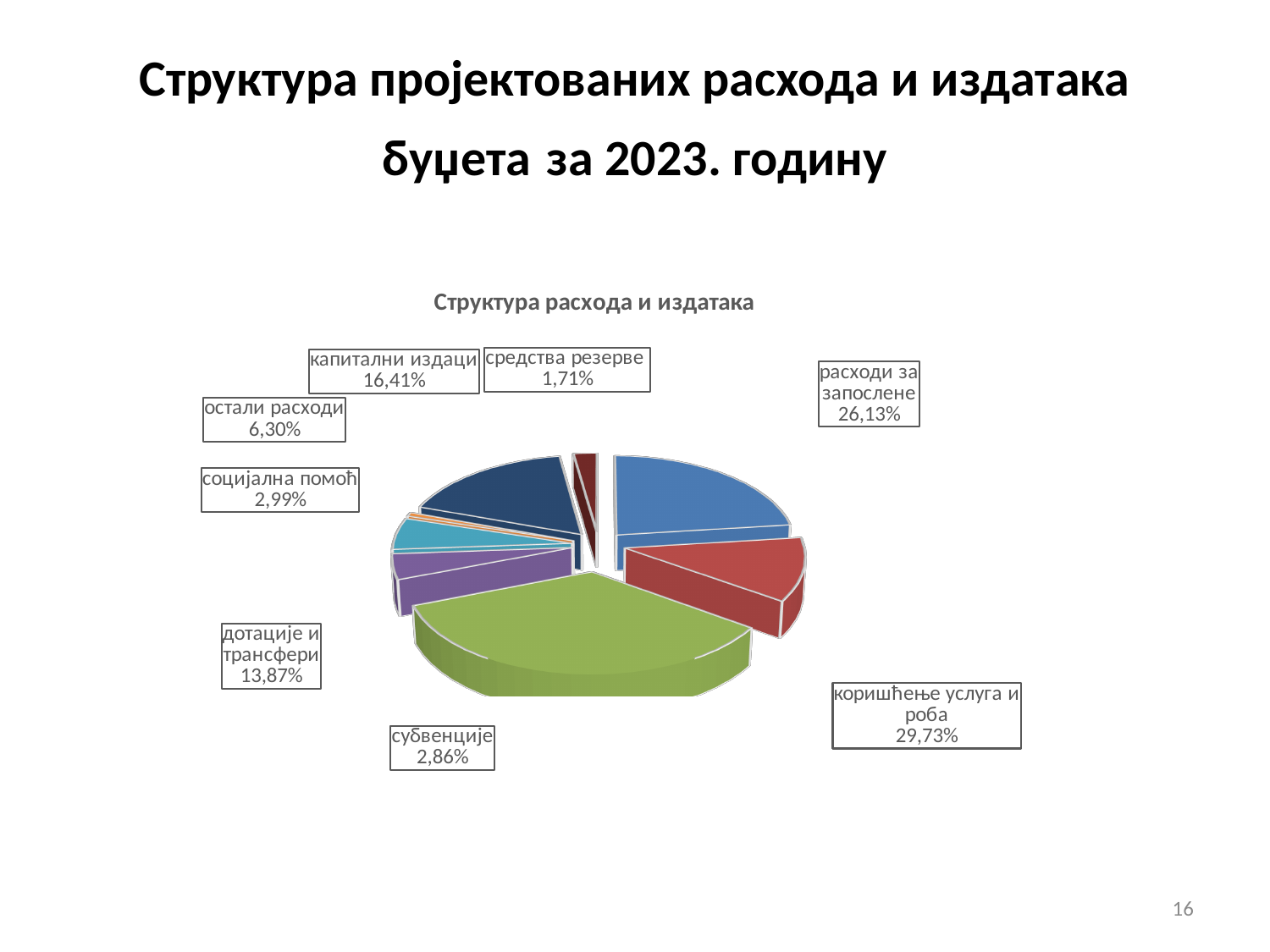
How many slices does the pie chart have? 8 Which category has the largest share of the pie? коришћење услуга и роба Which is larger, the share for остали расходи or the share for социјална помоћ? остали расходи What share of the pie is labelled for расходи за запослене? 26,13% What is the difference in percentage points between коришћење услуга и роба and расходи за запослене? 3,60 What kind of chart is shown on the slide? pie chart What share of the pie is labelled for коришћење услуга и роба? 29,73% Which category has the smallest share of the pie? средства резерве What share of the pie is labelled for средства резерве? 1,71% What is the chart's title? Структура расхода и издатака What share of the pie is labelled for дотације и трансфери? 13,87% What share of the pie is labelled for капитални издаци? 16,41%